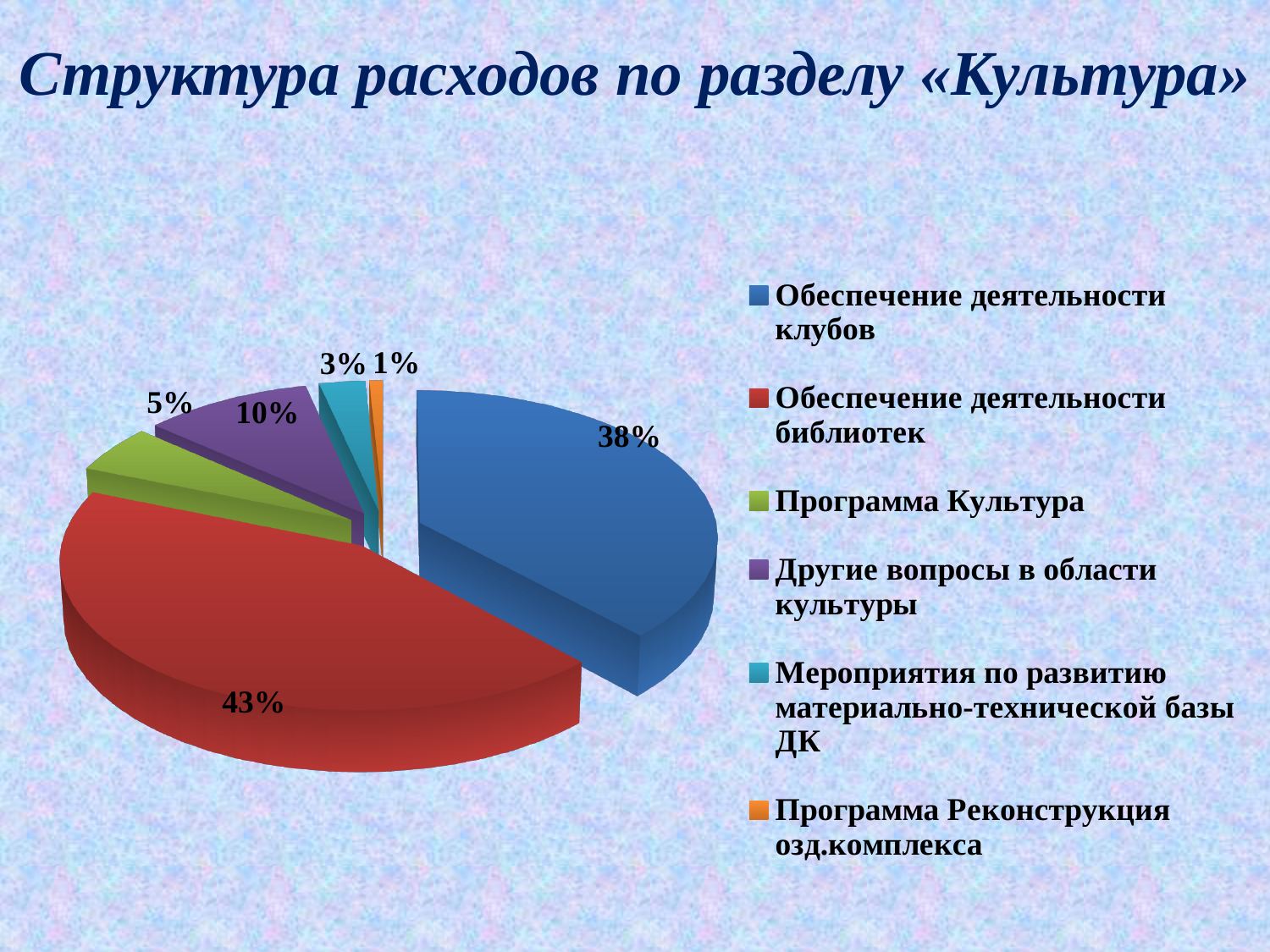
What share of expenditure goes to «Программа Культура»? 5% What share of expenditure goes to «Обеспечение деятельности клубов»? 38% Which category has the largest share of expenditure? Обеспечение деятельности библиотек What share of expenditure goes to «Другие вопросы в области культуры»? 10% What is the difference in percentage points between «Обеспечение деятельности библиотек» and «Обеспечение деятельности клубов»? 5 What share of expenditure goes to «Обеспечение деятельности библиотек»? 43% What type of chart is shown on the slide? Pie chart How many categories does the pie chart show? 6 Which is larger: the share for «Программа Культура» or for «Другие вопросы в области культуры»? Другие вопросы в области культуры What share of expenditure goes to «Программа Реконструкция озд.комплекса»? 1% Which category has the smallest share of expenditure? Программа Реконструкция озд.комплекса What share of expenditure goes to «Мероприятия по развитию материально-технической базы ДК»? 3%